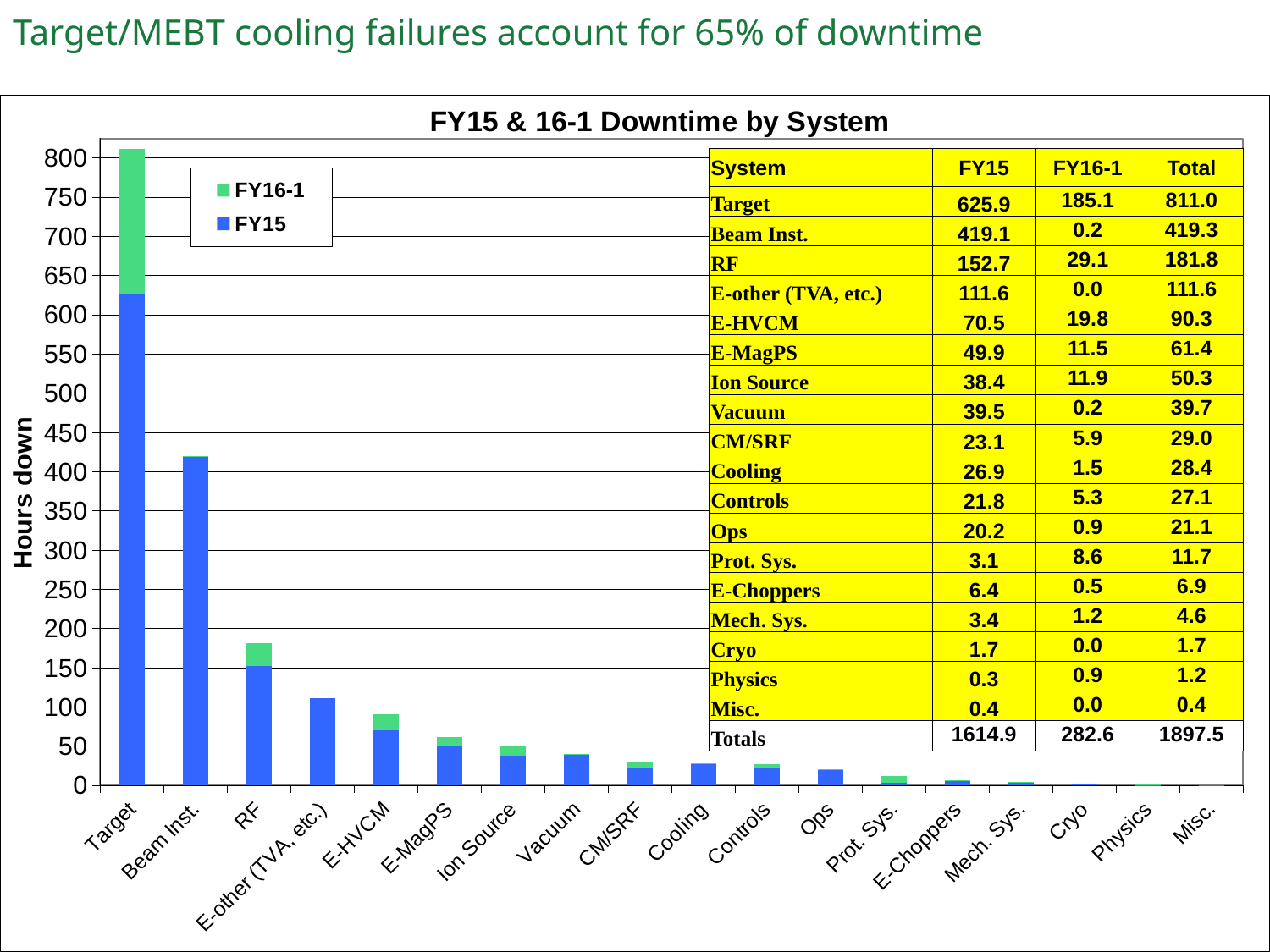
What is the difference between the FY15 values for Target and Beam Inst.? 206.8 What is the FY15 downtime value for Beam Inst.? 419.1 Do the total downtime values generally rise or fall moving from left to right along the x axis? fall Which system has the highest total downtime? Target What is the total downtime for Target (FY15 plus FY16-1)? 811.0 What is the title of the chart? FY15 & 16-1 Downtime by System How many system categories are plotted along the x axis? 18 Is the total downtime for E-other (TVA, etc.) greater or less than 100 hours? greater What kind of chart is shown on the slide? stacked bar chart Which has a larger FY15 downtime, E-HVCM or E-MagPS? E-HVCM What is the FY16-1 downtime value for RF? 29.1 How many series does the chart legend list? 2